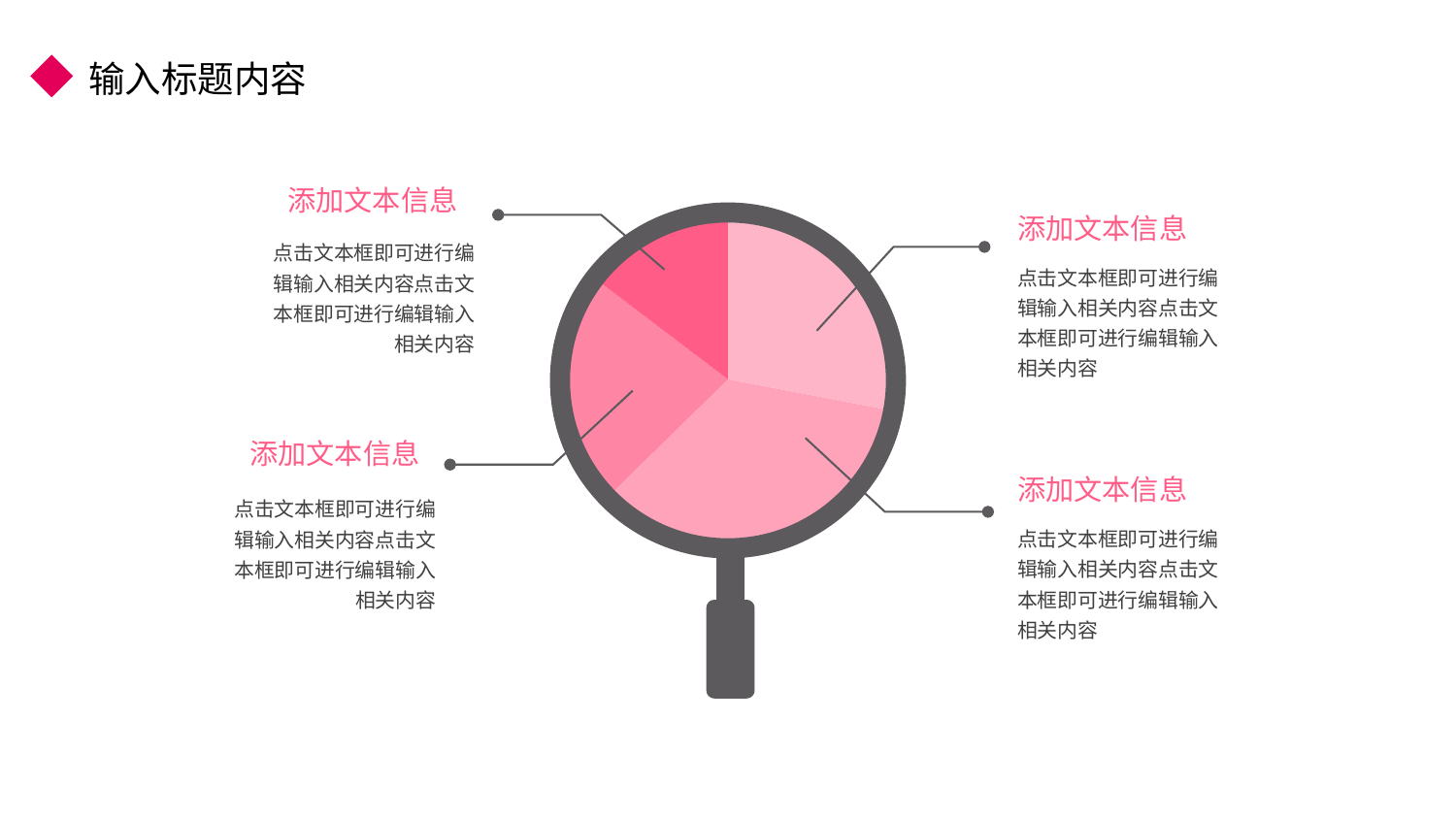
Which slice of the pie chart is the smallest: the dark pink slice at the top left, or the light pink slice at the top right? the dark pink slice at the top left Which slice of the pie chart is the smallest? the dark pink slice at the top left Is the dark pink slice at the top left of the pie chart larger or smaller than the slice at the bottom right? smaller How many text labels reading 添加文本信息 are placed around the pie chart? 4 How many slices does the pie chart on the slide have? 4 Does the pie chart on the slide show any data labels with values? No What kind of chart is shown inside the magnifying glass on the slide? pie chart